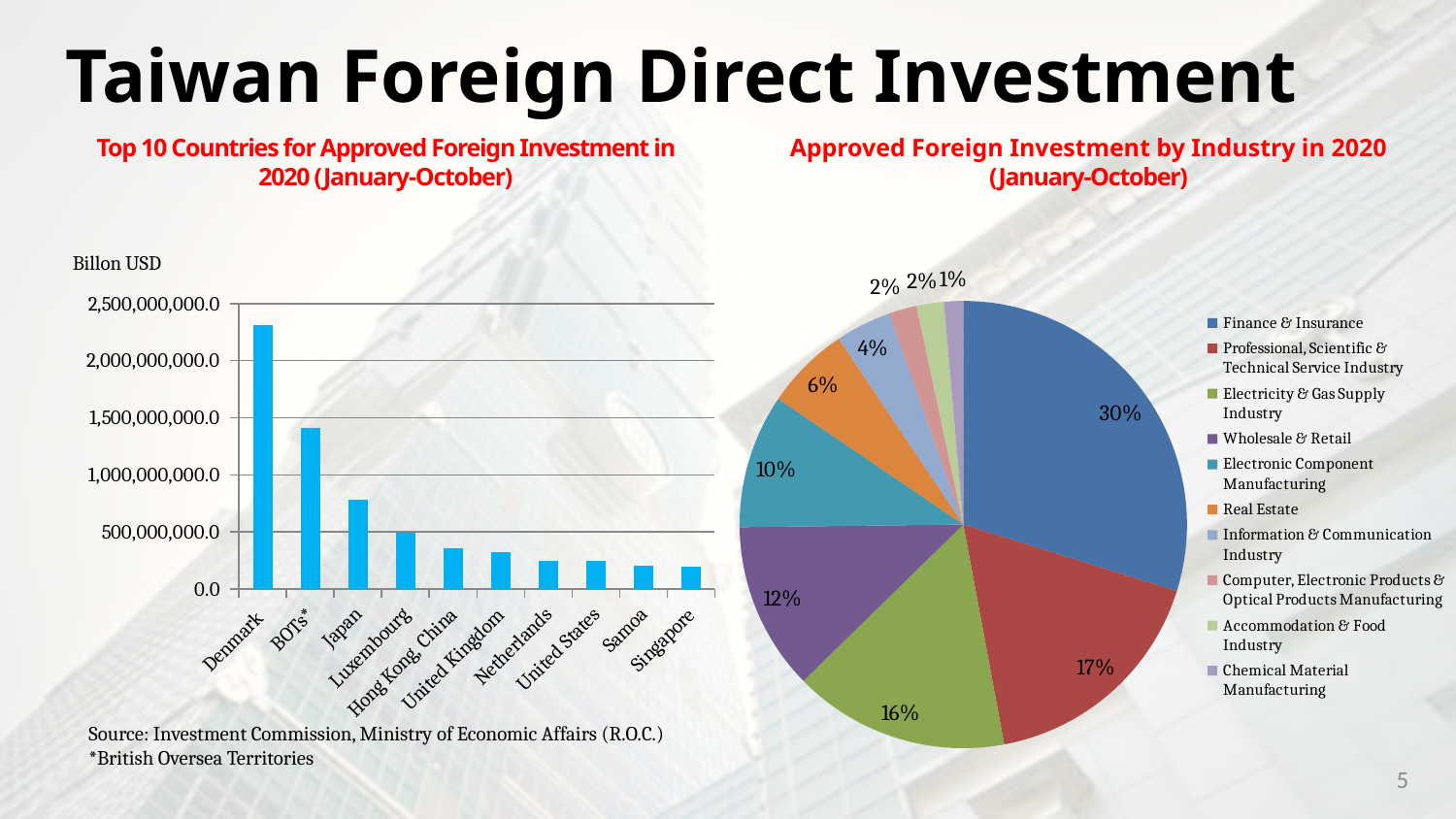
In the 'Top 10 Countries' bar chart, is the value for Japan greater or less than 1,000,000,000.0? less How many countries are shown in the 'Top 10 Countries' bar chart? 10 In the 'Approved Foreign Investment by Industry' pie chart, what share does Finance & Insurance have? 30% In the 'Top 10 Countries' bar chart, do the values rise or fall from left to right along the x axis? Fall How many industries does the legend of the 'Approved Foreign Investment by Industry' pie chart list? 10 In the 'Approved Foreign Investment by Industry' pie chart, what is the difference between the Finance & Insurance share and the Professional, Scientific & Technical Service Industry share? 13% What kind of chart is the 'Top 10 Countries for Approved Foreign Investment in 2020 (January-October)' chart? Bar chart In the 'Top 10 Countries' bar chart, which country has the highest approved foreign investment? Denmark In the 'Top 10 Countries' bar chart, is the value for BOTs* greater or less than 1,500,000,000.0? less In the 'Approved Foreign Investment by Industry' pie chart, what share does Wholesale & Retail have? 12% In the 'Top 10 Countries' bar chart, is the value for Denmark greater or less than 2,000,000,000.0? greater What kind of chart is the 'Approved Foreign Investment by Industry in 2020 (January-October)' chart? Pie chart